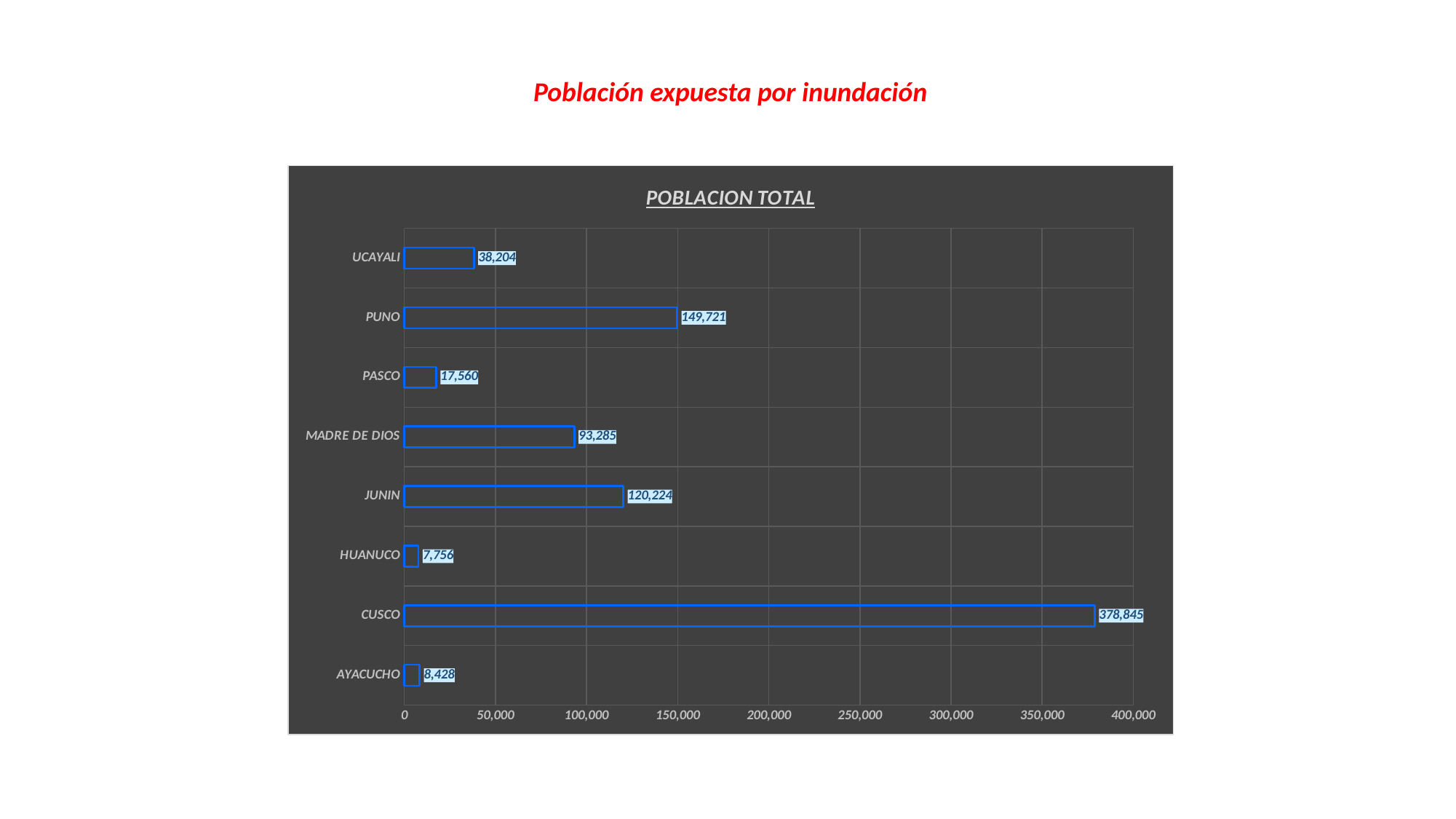
What is the difference between the values for PUNO and JUNIN? 29,497 Which category has the highest value? CUSCO What is the value for PUNO? 149,721 Which category has the lowest value? HUANUCO What kind of chart is shown on the slide? bar chart Which is larger, the value for UCAYALI or the value for PASCO? UCAYALI What is the difference between the values for AYACUCHO and HUANUCO? 672 How many categories are shown in the chart? 8 What is the value for MADRE DE DIOS? 93,285 Is the value for JUNIN greater or less than 100,000? greater What is the value for CUSCO? 378,845 What is the title of the chart? POBLACION TOTAL